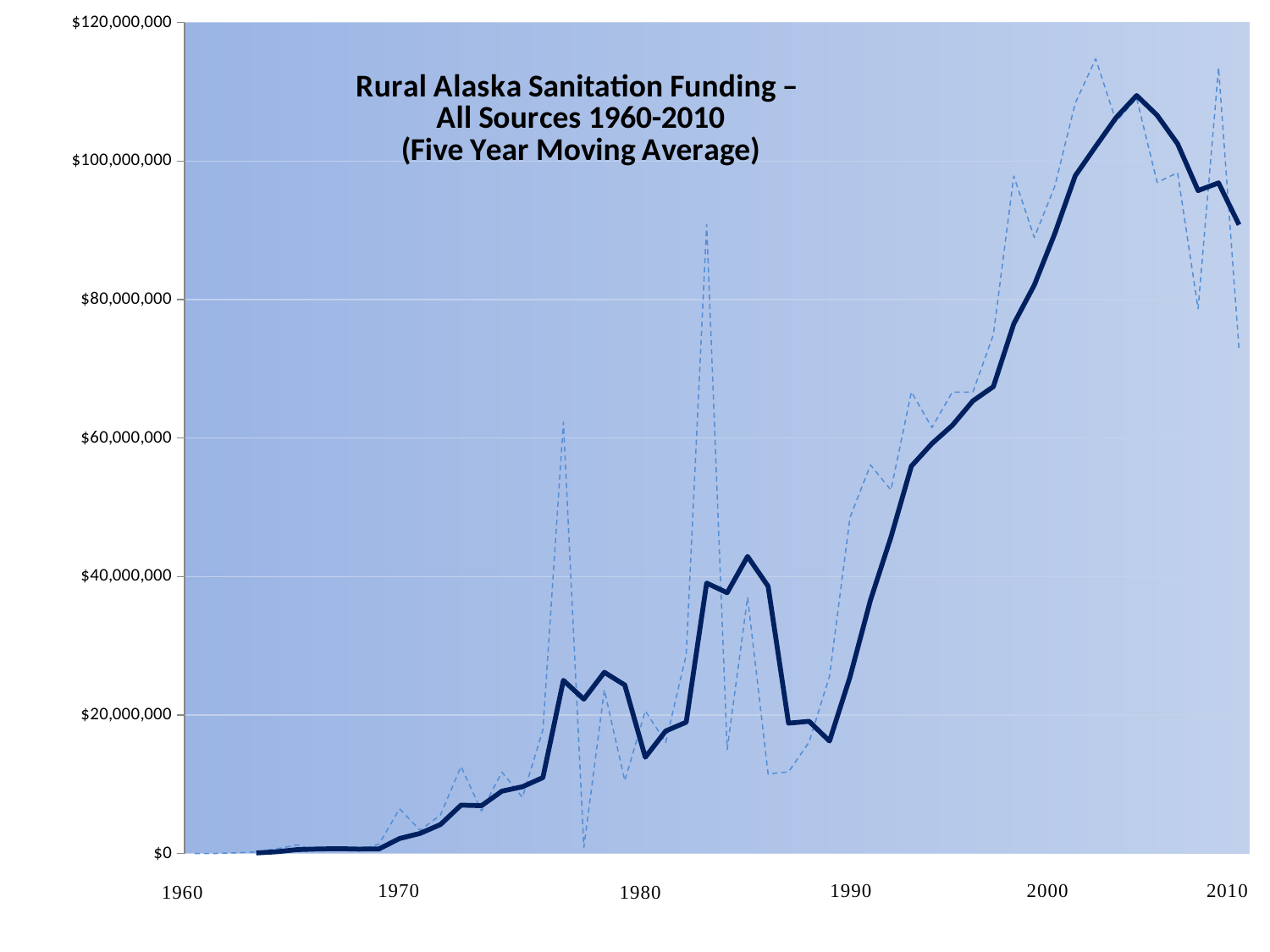
Is the value of the solid line at 2000 greater or less than $80,000,000? greater How many year labels are shown on the x axis? 6 What is the title of the chart? Rural Alaska Sanitation Funding – All Sources 1960-2010 (Five Year Moving Average) Overall, does the solid line rise or fall from 1960 to 2010? Rise Does the solid line rise or fall between 2005 and 2010? Fall Is the highest point of the solid line greater or less than $100,000,000? greater Is the value of the solid line at 1990 greater or less than $40,000,000? less How many lines are plotted on the chart? 2 What kind of chart is shown on the slide? Line chart Which year has the larger value on the solid line, 1990 or 2000? 2000 What is the highest value shown on the y axis? $120,000,000